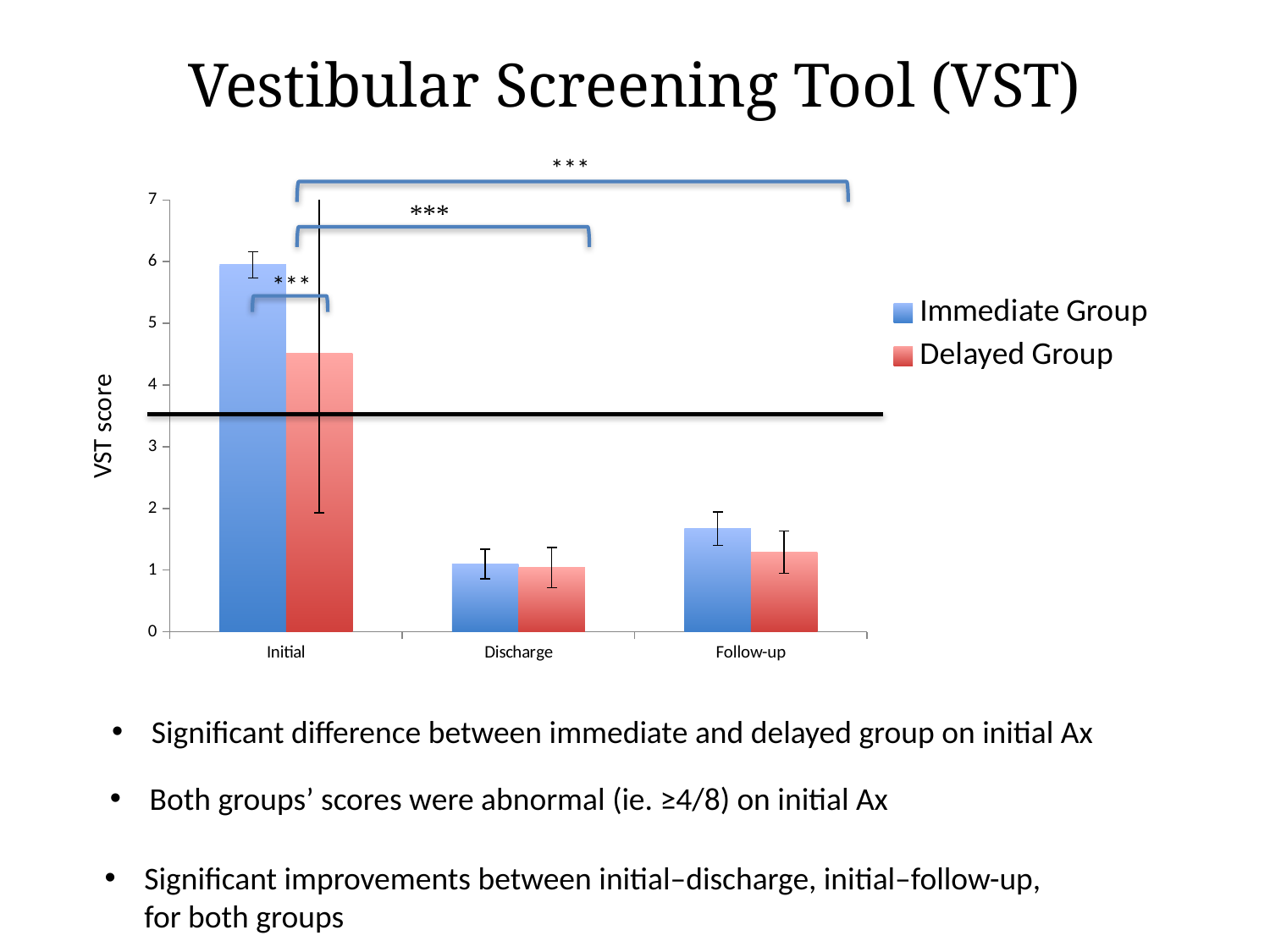
Is the Immediate Group's VST score at Discharge greater or less than 2? less Which colour represents the Delayed Group in the chart? red Is the Immediate Group's VST score at Initial greater or less than 5? greater At the Initial assessment, which group has the higher VST score, the Immediate Group or the Delayed Group? Immediate Group How many series does the chart legend list? 2 Which category has the lowest VST score for the Delayed Group? Discharge What is the label of the y axis of the chart? VST score At Follow-up, which group has the higher VST score, the Immediate Group or the Delayed Group? Immediate Group Is the Delayed Group's VST score at Initial greater or less than 4? greater Which category has the highest VST score for the Immediate Group? Initial How many categories are shown on the x axis of the chart? 3 What kind of chart is shown on the slide? bar chart